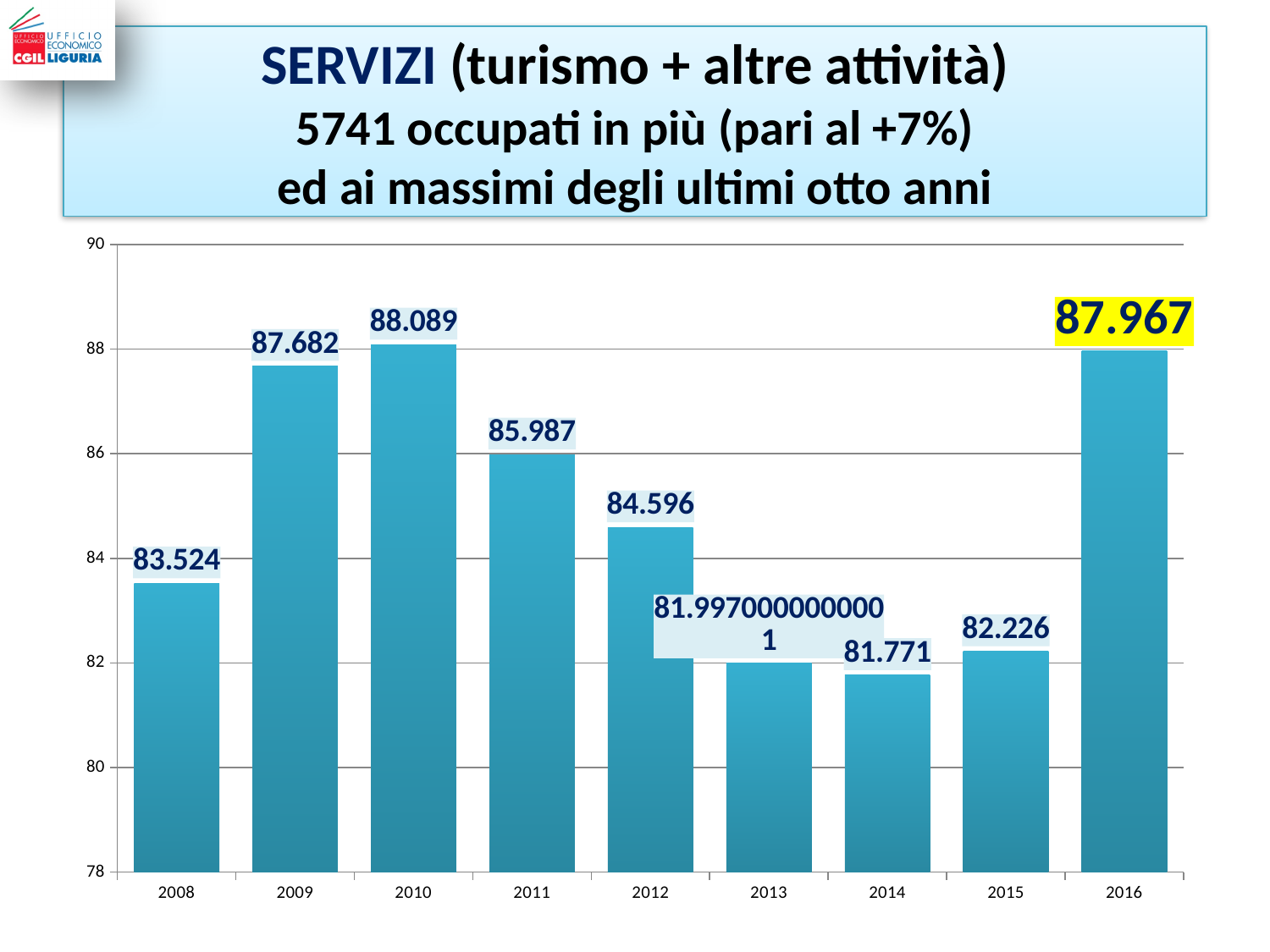
Which is larger, the value for 2009 or the value for 2016? 2016 How many years are shown on the x axis? 9 What is the value for 2015? 82.226 What is the value for 2016? 87.967 What kind of chart is shown on the slide? bar chart What is the value for 2008? 83.524 What is the difference between the values for 2010 and 2014? 6.318 Which year has the highest value? 2010 Which year has the lowest value? 2014 Is the value for 2011 greater or less than 84? greater What is the difference between the values for 2016 and 2015? 5.741 Do the values rise or fall from 2010 to 2014? fall